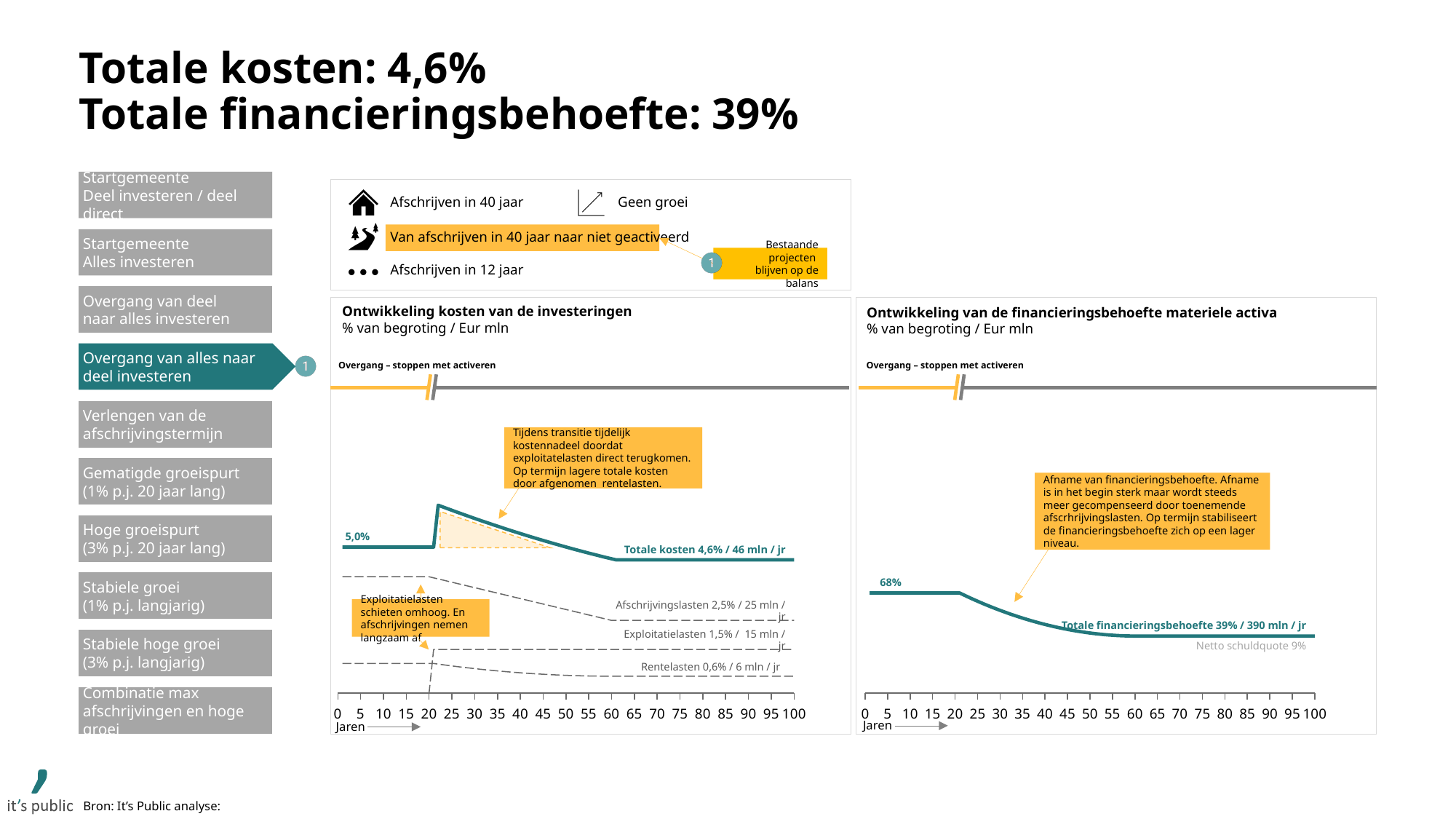
In the left chart 'Ontwikkeling kosten van de investeringen', which labelled cost component has the lowest end value: Afschrijvingslasten, Exploitatielasten or Rentelasten? Rentelasten In the right chart 'Ontwikkeling van de financieringsbehoefte materiele activa', what is the starting value of the line at year 0? 68% In the right chart 'Ontwikkeling van de financieringsbehoefte materiele activa', does the financing need rise or fall over the years after the transition? Fall In the right chart 'Ontwikkeling van de financieringsbehoefte materiele activa', what is the total financing need at the end of the period? 39% / 390 mln / jr In the left chart 'Ontwikkeling kosten van de investeringen', what is the end value labelled for Rentelasten? 0,6% / 6 mln / jr In the left chart 'Ontwikkeling kosten van de investeringen', what is the difference in percentage points between the starting total cost (5,0%) and the final total cost (4,6%)? 0,4% In the left chart 'Ontwikkeling kosten van de investeringen', what are the total costs at the end of the period? 4,6% / 46 mln / jr What is the last year shown on the x axis of the left chart 'Ontwikkeling kosten van de investeringen'? 100 In the left chart 'Ontwikkeling kosten van de investeringen', what is the starting value of the total cost line at year 0? 5,0% In the right chart 'Ontwikkeling van de financieringsbehoefte materiele activa', what is the Netto schuldquote shown at the end? 9% What kind of chart is the left chart, 'Ontwikkeling kosten van de investeringen'? Line chart In the left chart 'Ontwikkeling kosten van de investeringen', what is the end value labelled for Afschrijvingslasten? 2,5% / 25 mln / jr